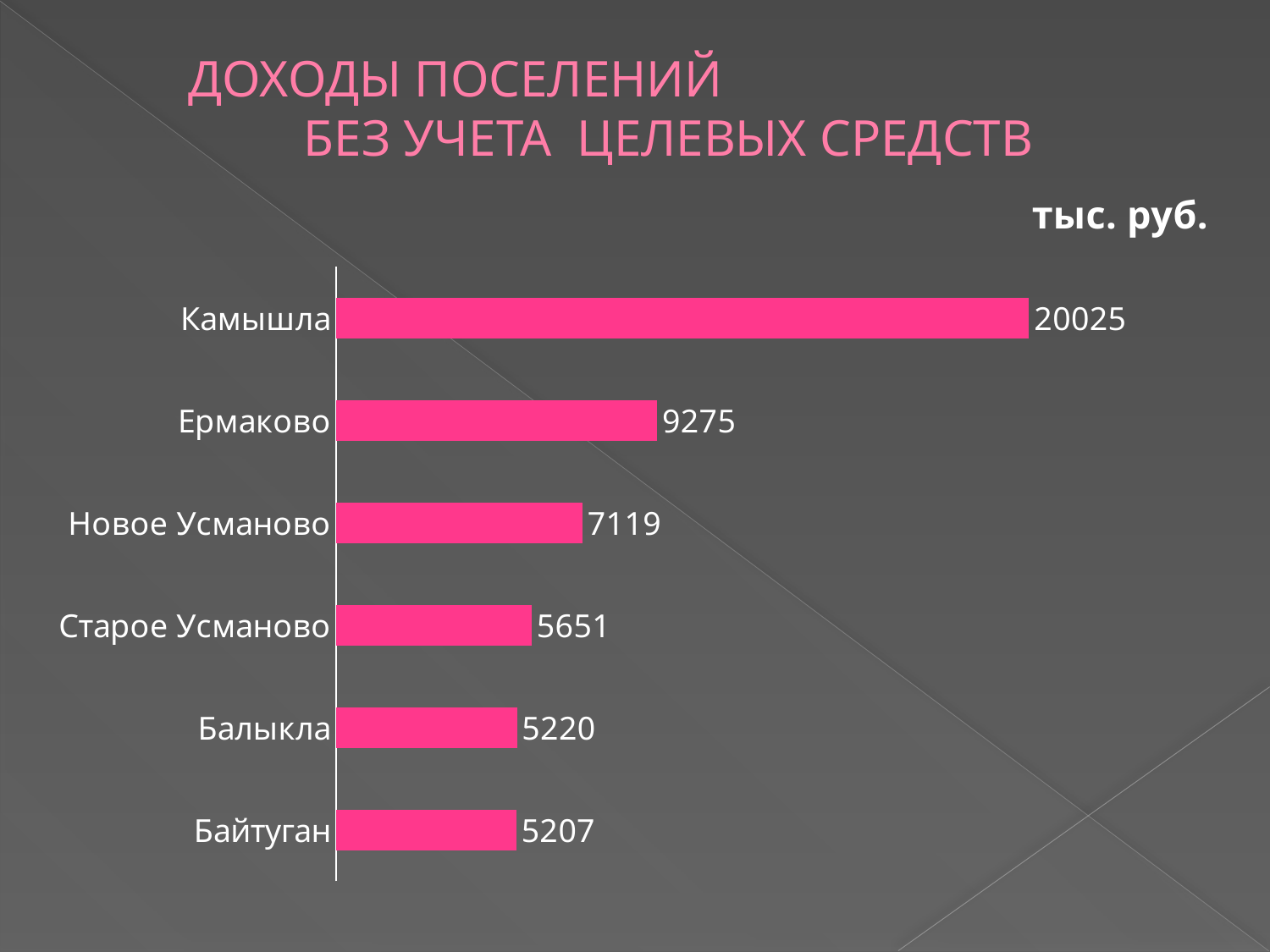
What kind of chart is shown on the slide? Bar chart How many settlements are shown in the chart? 6 What is the value for Ермаково? 9275 Which settlement has the highest income? Камышла Which is larger, the value for Ермаково or the value for Новое Усманово? Ермаково What is the difference between the values for Камышла and Ермаково? 10750 What is the value for Камышла? 20025 What is the value for Байтуган? 5207 What is the value for Новое Усманово? 7119 What is the difference between the values for Новое Усманово and Старое Усманово? 1468 Which settlement has the lowest income? Байтуган What is the value for Старое Усманово? 5651